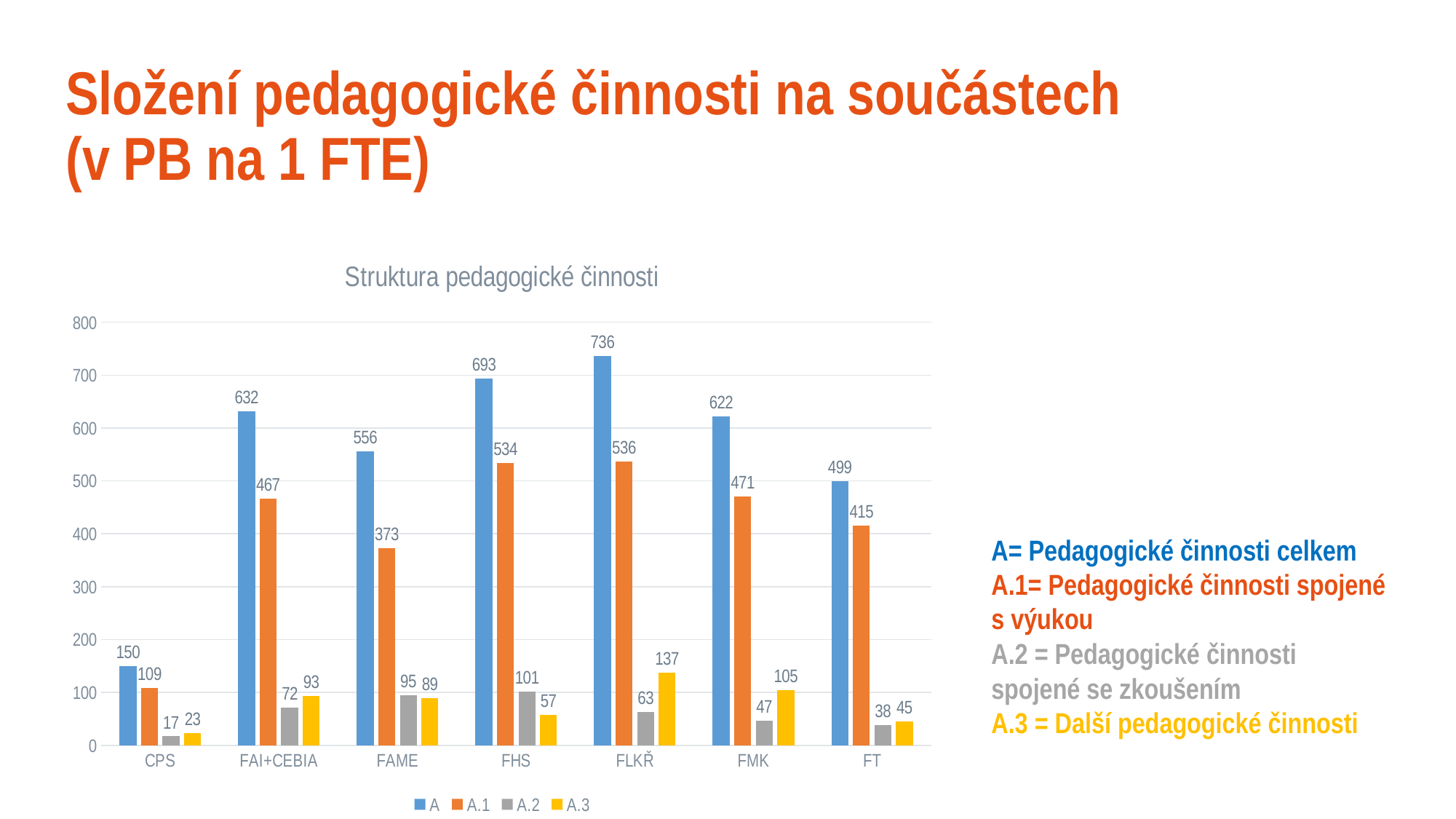
How many series does the legend list? 4 What kind of chart is shown? bar chart How many categories are shown on the x axis? 7 What is the value of series A.1 for FAME? 373 What is the value of series A for FHS? 693 Which category has the lowest value for series A.1? CPS What is the value of series A.2 for CPS? 17 What is the value of series A.3 for FLKŘ? 137 Which is larger: series A.3 for FT or series A.3 for FMK? FMK What is the difference between series A and series A.1 for FMK? 151 What is the title of the chart? Struktura pedagogické činnosti Which category has the highest value for series A? FLKŘ